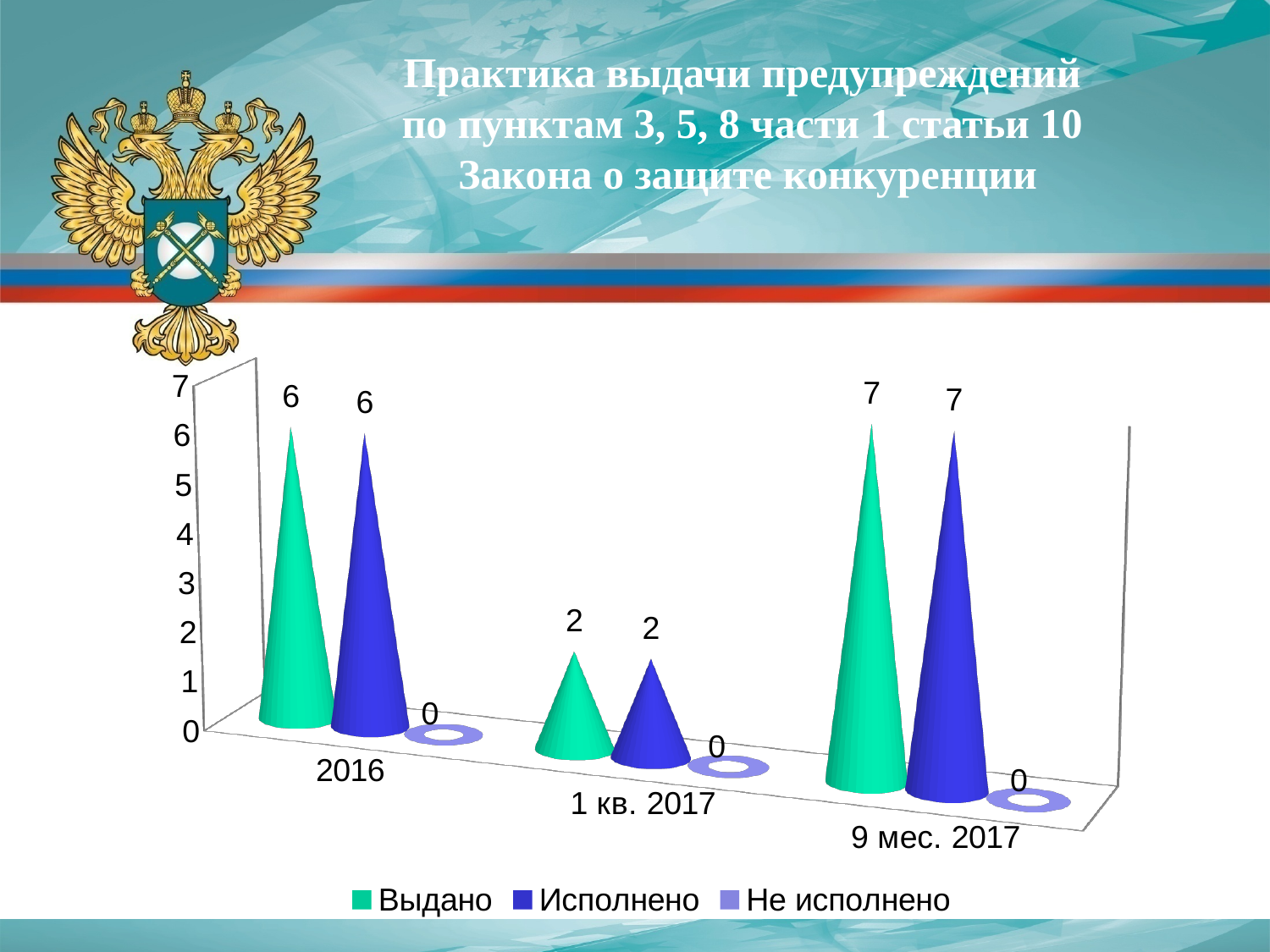
Which category has the highest value for Выдано? 9 мес. 2017 What is the difference between the Выдано values for 9 мес. 2017 and 1 кв. 2017? 5 How many categories are shown on the x axis? 3 What is the value for Выдано in 2016? 6 What is the value for Не исполнено in 9 мес. 2017? 0 How many series does the legend list? 3 What is the value for Исполнено in 1 кв. 2017? 2 What is the value for Выдано in 9 мес. 2017? 7 Which is larger: Исполнено in 2016 or Исполнено in 9 мес. 2017? 9 мес. 2017 Which category has the lowest value for Исполнено? 1 кв. 2017 What is the total of Выдано, Исполнено and Не исполнено for 2016? 12 What kind of chart is shown on the slide? bar chart